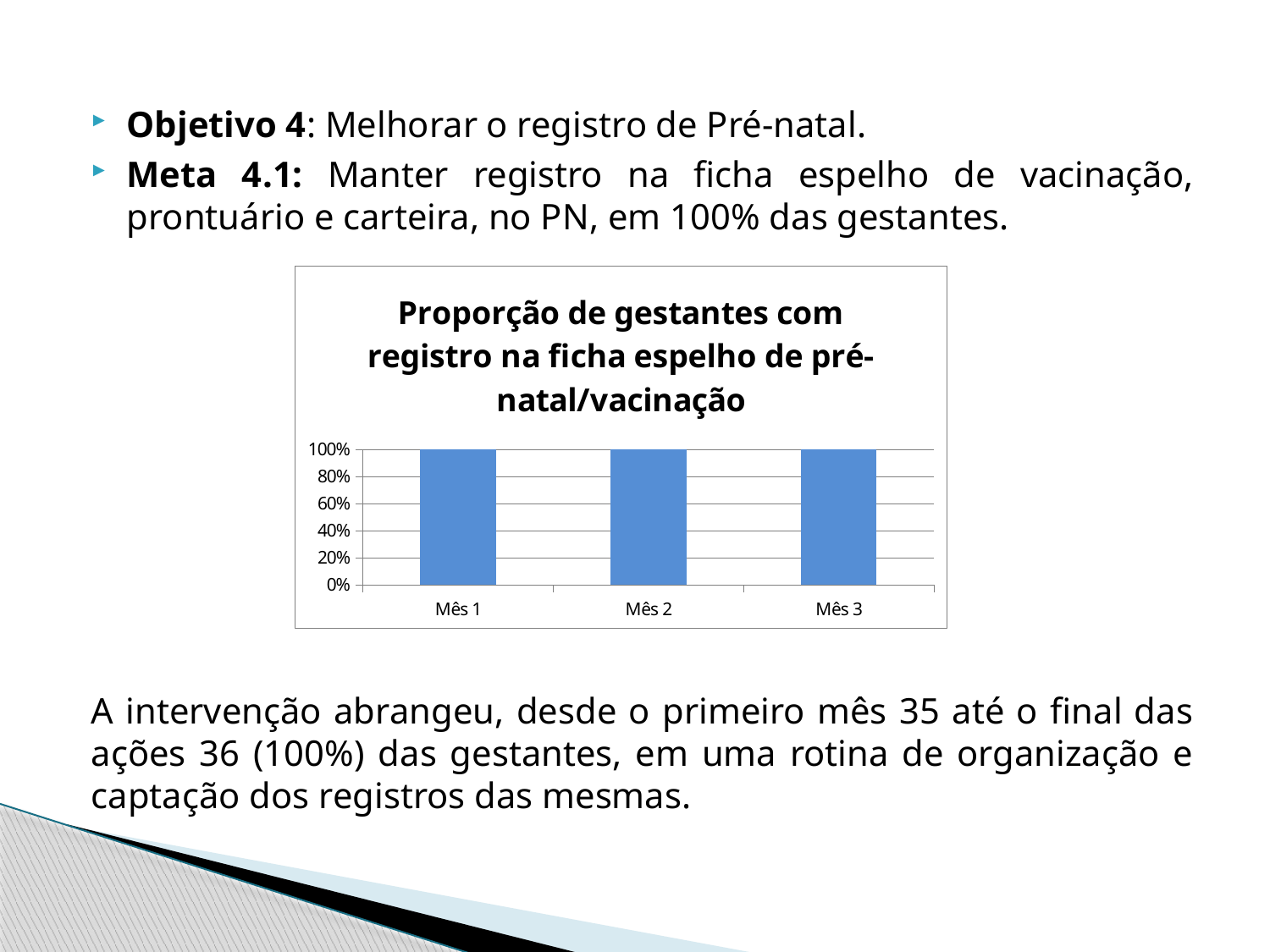
What is the title of the chart? Proporção de gestantes com registro na ficha espelho de pré-natal/vacinação What is the value for Mês 3 in the chart? 100% What is the highest value shown on the y axis of the chart? 100% What is the value for Mês 2 in the chart? 100% What kind of chart is shown on the slide? bar chart Do the values rise, fall, or stay flat from Mês 1 to Mês 3? stay flat How many categories are plotted on the x axis of the chart? 3 What is the value for Mês 1 in the chart? 100% Is the value for Mês 1 greater or less than 80%? greater What is the difference between the values for Mês 1 and Mês 3? 0% Is the value for Mês 3 greater or less than 60%? greater What is the label of the first category on the x axis? Mês 1